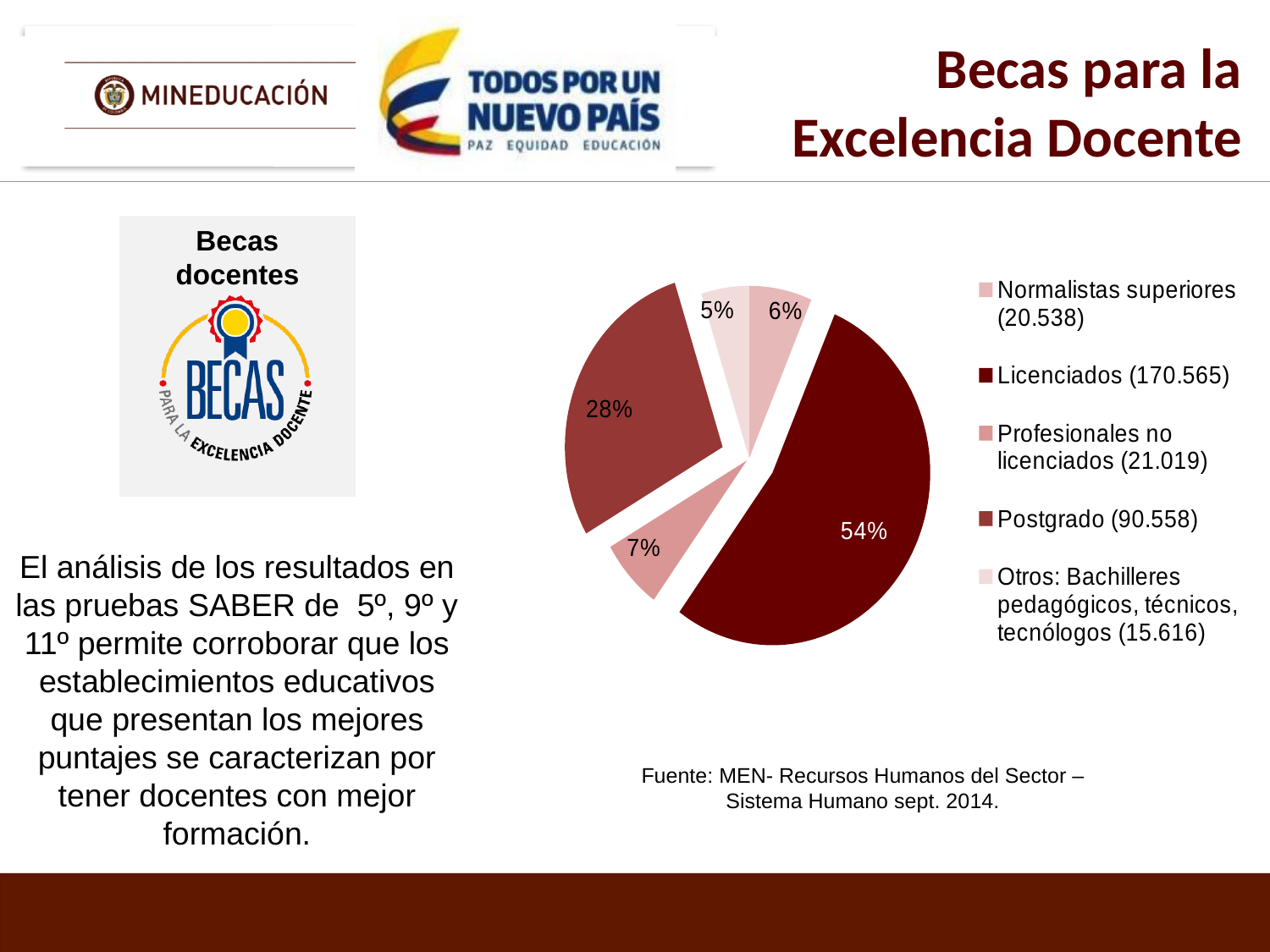
Which category has the largest slice of the pie? Licenciados How many entries does the legend of the pie chart list? 5 How many slices does the pie chart have? 5 What number is shown in the legend next to Licenciados? 170.565 What type of chart is shown on the slide? pie chart Which category has the smallest slice of the pie? Otros: Bachilleres pedagógicos, técnicos, tecnólogos Which slice is larger, Postgrado or Profesionales no licenciados? Postgrado What is the difference in percentage points between the Licenciados slice and the Postgrado slice? 26 What percentage of the pie does the Postgrado slice represent? 28% What percentage of the pie does the Normalistas superiores slice represent? 6% What percentage of the pie does the Licenciados slice represent? 54%